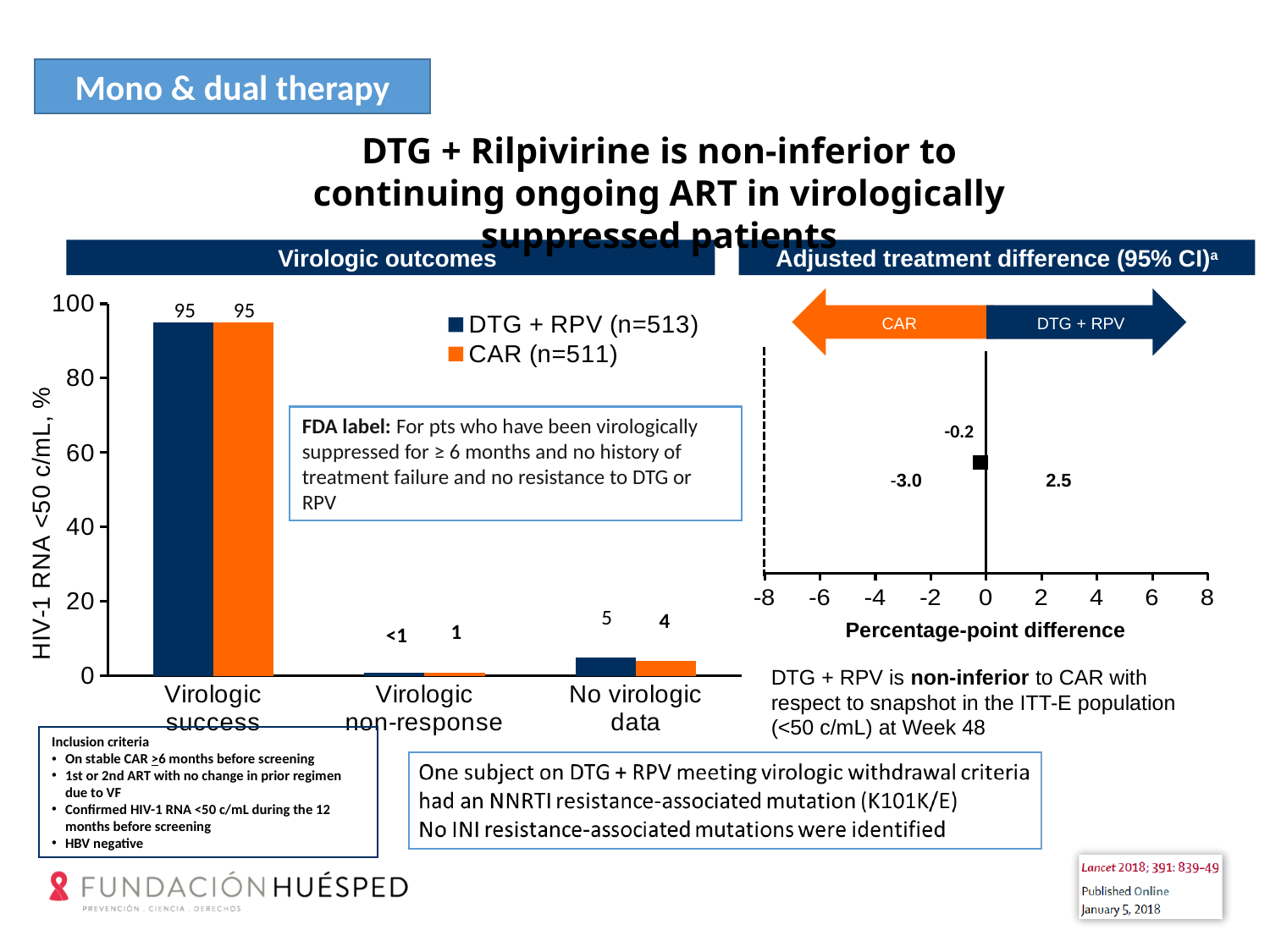
In the Adjusted treatment difference (95% CI) chart, what are the lower and upper bounds of the confidence interval? -3.0 and 2.5 In the Virologic outcomes chart, what is the value for DTG + RPV in the Virologic success category? 95 In the Adjusted treatment difference (95% CI) chart, what is the point estimate of the percentage-point difference? -0.2 In the Virologic outcomes chart, what is the value for CAR in the No virologic data category? 4 How many categories are shown on the x axis of the Virologic outcomes chart? 3 In the Virologic outcomes chart, which is larger in the No virologic data category, DTG + RPV or CAR? DTG + RPV In the Virologic outcomes chart, what is the difference between the DTG + RPV and CAR values in the No virologic data category? 1 How many series does the legend of the Virologic outcomes chart list? 2 What kind of chart is the Virologic outcomes chart? Bar chart In the Virologic outcomes chart, what is the value for CAR in the Virologic non-response category? 1 In the Virologic outcomes chart, which category has the highest value for CAR? Virologic success In the Virologic outcomes chart, what is the value for DTG + RPV in the Virologic non-response category? <1